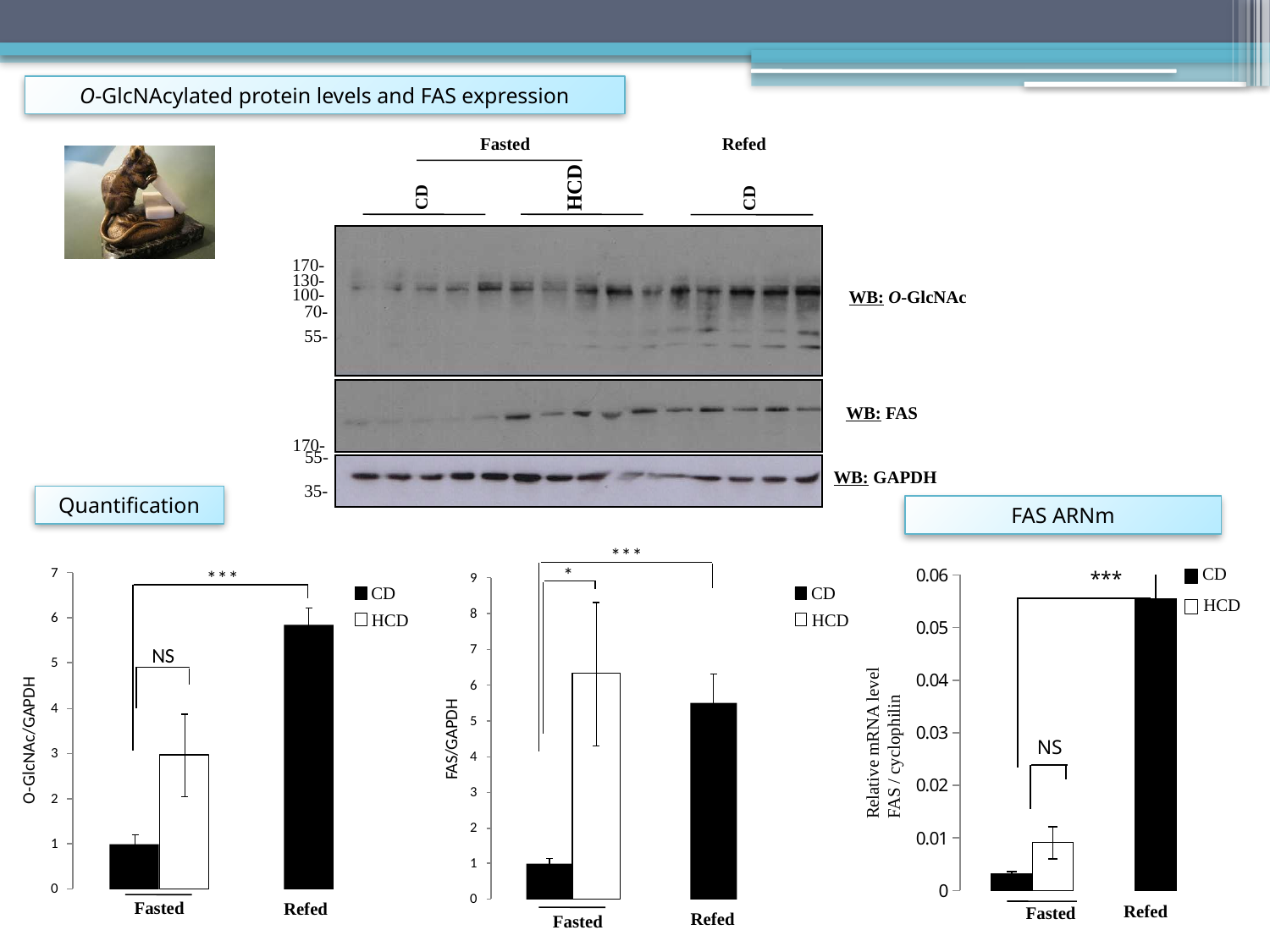
In the FAS ARNm chart on the right, which is larger, the Fasted CD bar or the Fasted HCD bar? Fasted HCD What kind of chart is the leftmost chart with the y-axis labelled O-GlcNAc/GAPDH? bar chart In the FAS ARNm chart on the right, is the value for Fasted HCD greater or less than 0.02? less What is the y-axis label of the FAS ARNm chart on the right? Relative mRNA level FAS / cyclophilin In the middle chart (FAS/GAPDH), which is larger, the Fasted CD bar or the Refed CD bar? Refed CD In the leftmost chart (O-GlcNAc/GAPDH), is the value for Refed CD greater or less than 5? greater In the leftmost chart (O-GlcNAc/GAPDH), is the value for Fasted HCD greater or less than 4? less In the middle chart (FAS/GAPDH), which bar is the lowest? Fasted CD In the leftmost chart (O-GlcNAc/GAPDH), which bar is the highest? Refed CD How many series does the legend of the leftmost chart (O-GlcNAc/GAPDH) list? 2